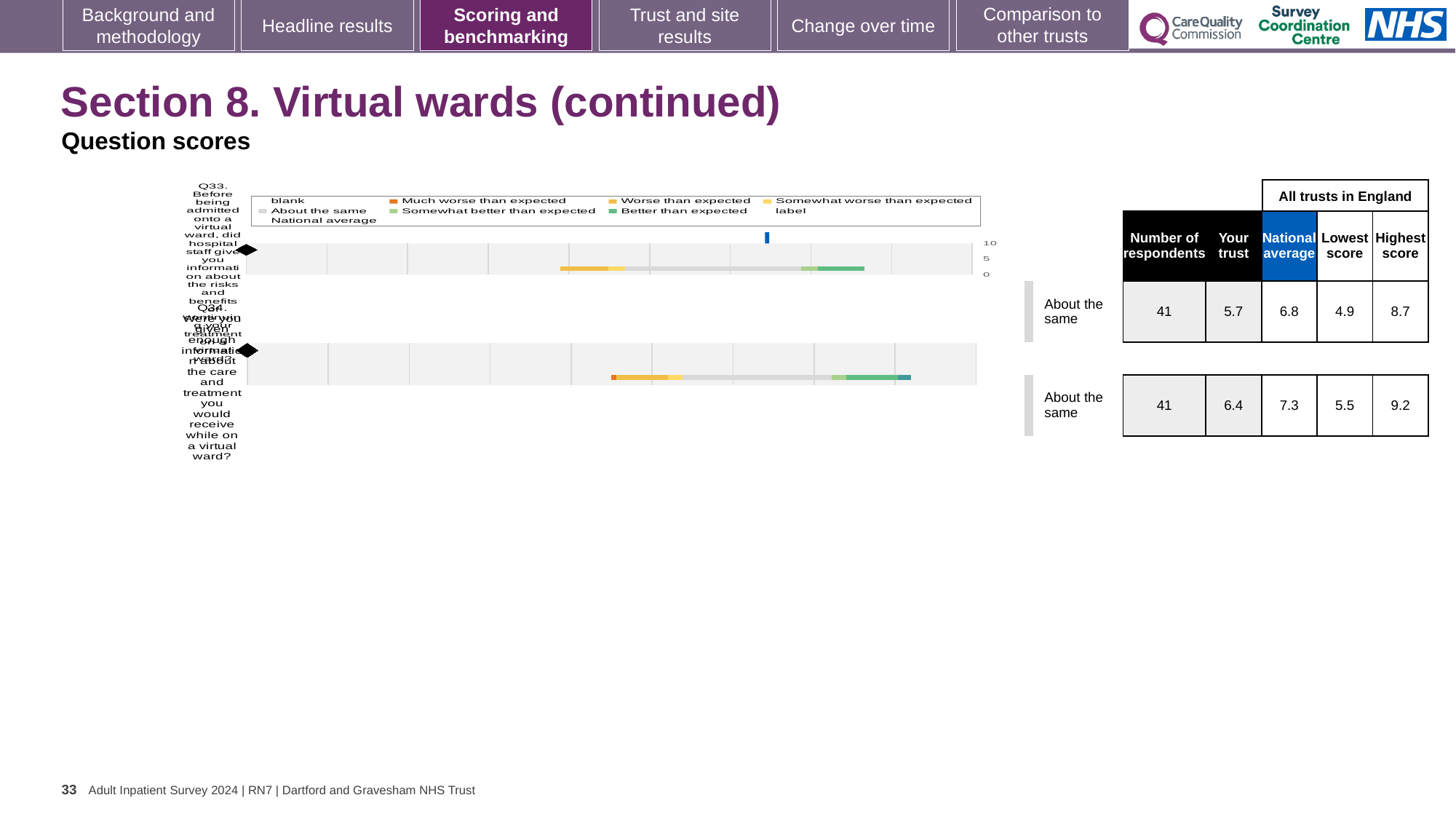
What benchmark category is shown next to the Q34 bar? About the same Is the 'Your trust' score for Q33 greater or less than 5? greater How many respondents answered Q33? 41 How many entries does the legend of the question scores chart list? 9 Which question has the higher 'Highest score' across all trusts in England, Q33 or Q34? Q34 What kind of chart is used to show the question scores for Q33 and Q34? Bar chart What is the difference between the highest score and the lowest score for Q33? 3.8 Which question has the higher 'Your trust' score, Q33 or Q34? Q34 How many questions (bars) are plotted in the question scores chart? 2 What is the 'Your trust' score for Q33 (information about the risks and benefits of a virtual ward)? 5.7 How much higher is the national average than the 'Your trust' score for Q34? 0.9 What is the national average score for Q34 (enough information about care and treatment on a virtual ward)? 7.3